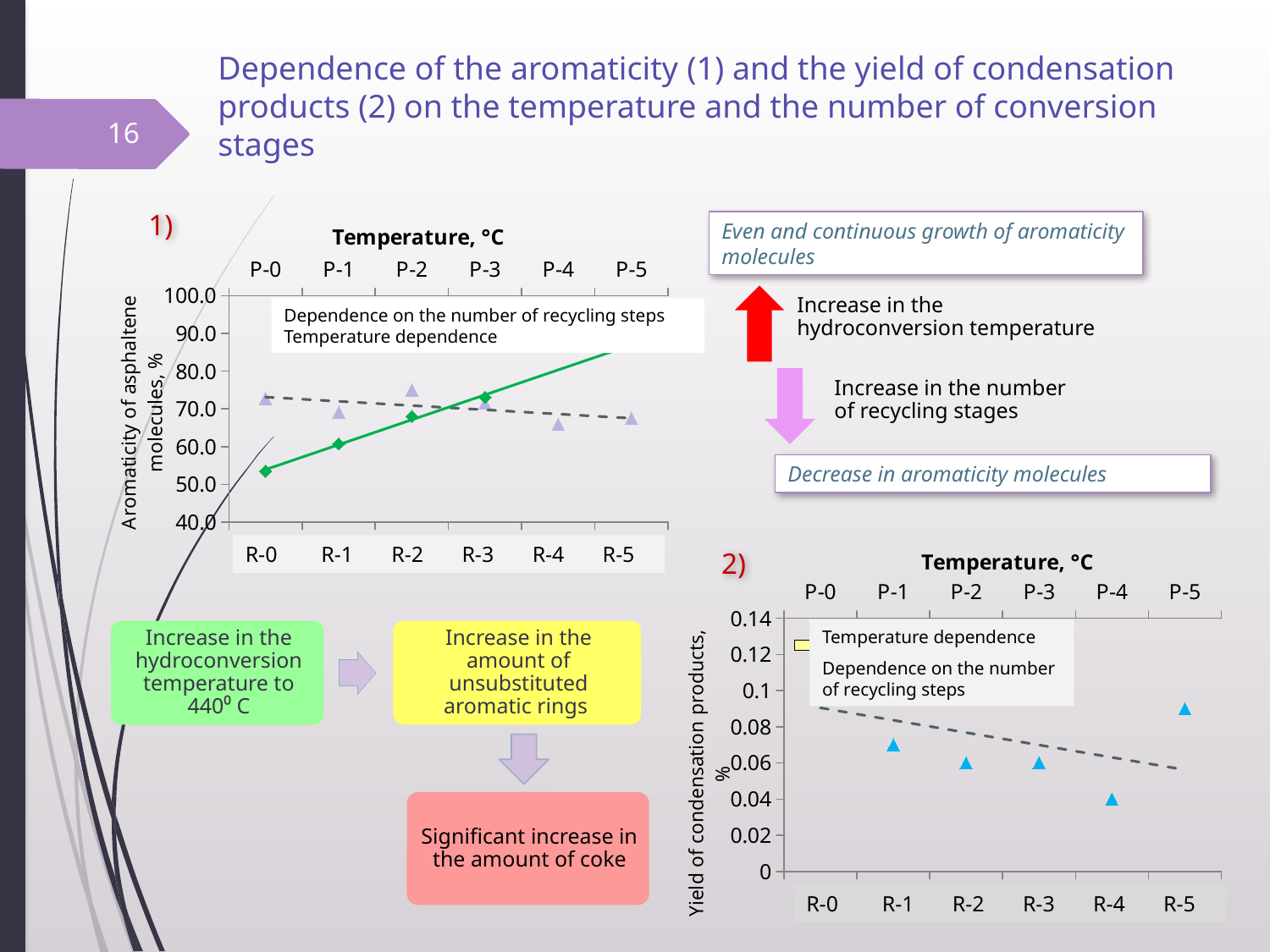
In chart 2, which category has the lowest plotted value? R-4 How many categories are shown on the bottom x axis of chart 1? 6 How many series does the legend of chart 1 list? 2 What is the title of the y axis of chart 2? Yield of condensation products, % In chart 1, do the values of the Temperature dependence series rise or fall from R-0 to R-3? rise In chart 1, which is larger for the Dependence on the number of recycling steps series: the value at R-2 or at R-4? R-2 What kind of chart is chart 1 (aromaticity of asphaltene molecules)? line chart In chart 1, is the Temperature dependence value at R-3 greater or less than 70.0? greater In chart 2, is the value at R-5 greater or less than 0.08? greater In chart 2, is the value at R-4 greater or less than 0.06? less In chart 2, which category has the highest plotted value? R-5